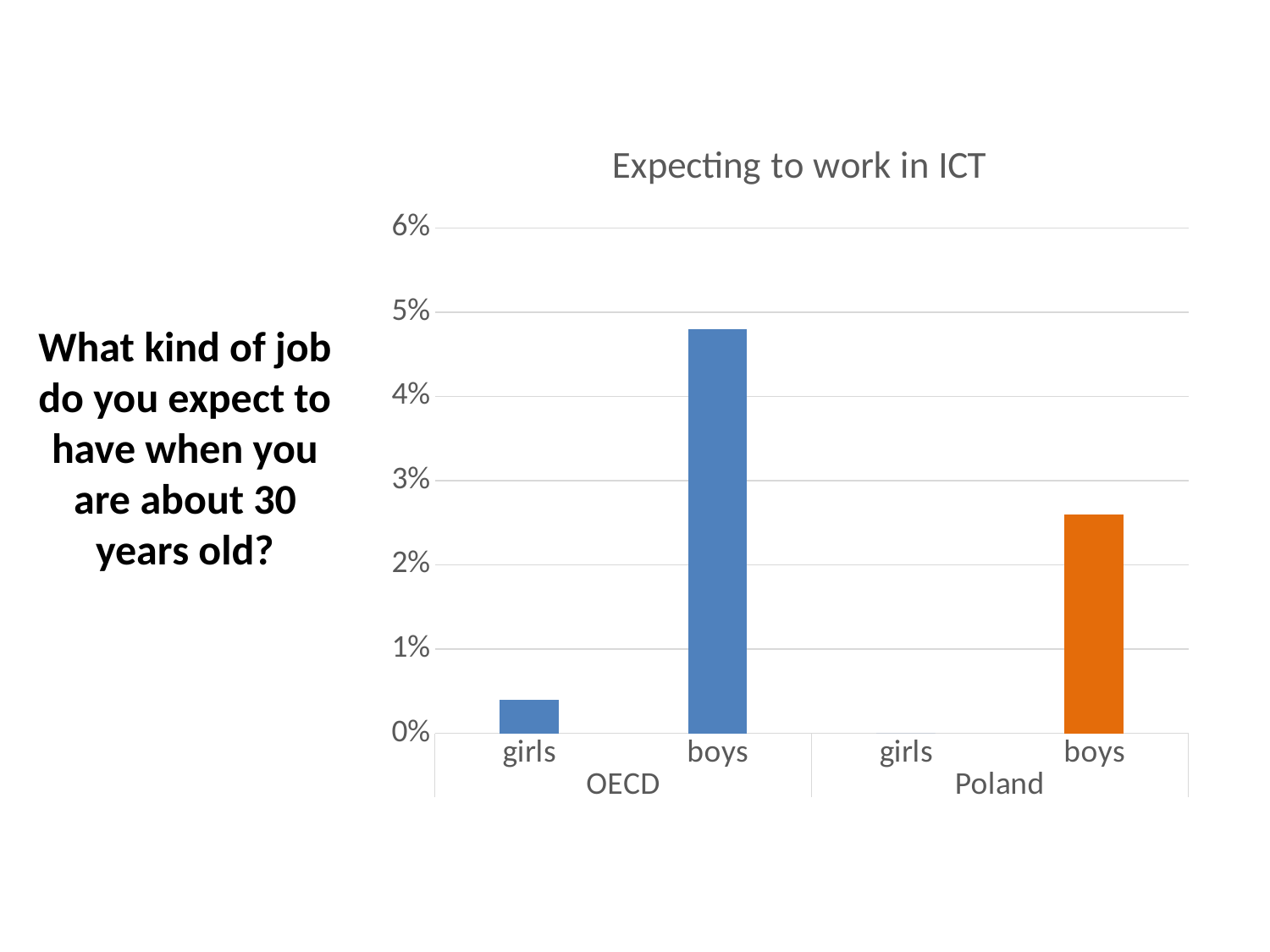
Is the value for Poland boys greater or less than 3%? less What colour are the bars for Poland? orange How many categories are shown on the x axis of the chart? 4 Which is larger, the value for OECD boys or the value for Poland boys? OECD boys Which group has the lowest value in the chart? Poland girls What is the title of the chart? Expecting to work in ICT What kind of chart is shown on the slide? bar chart Is the value for OECD boys greater or less than 4%? greater Is the value for OECD girls greater or less than 1%? less Which is larger, the value for OECD girls or the value for OECD boys? OECD boys Which bar is the highest in the chart? OECD boys